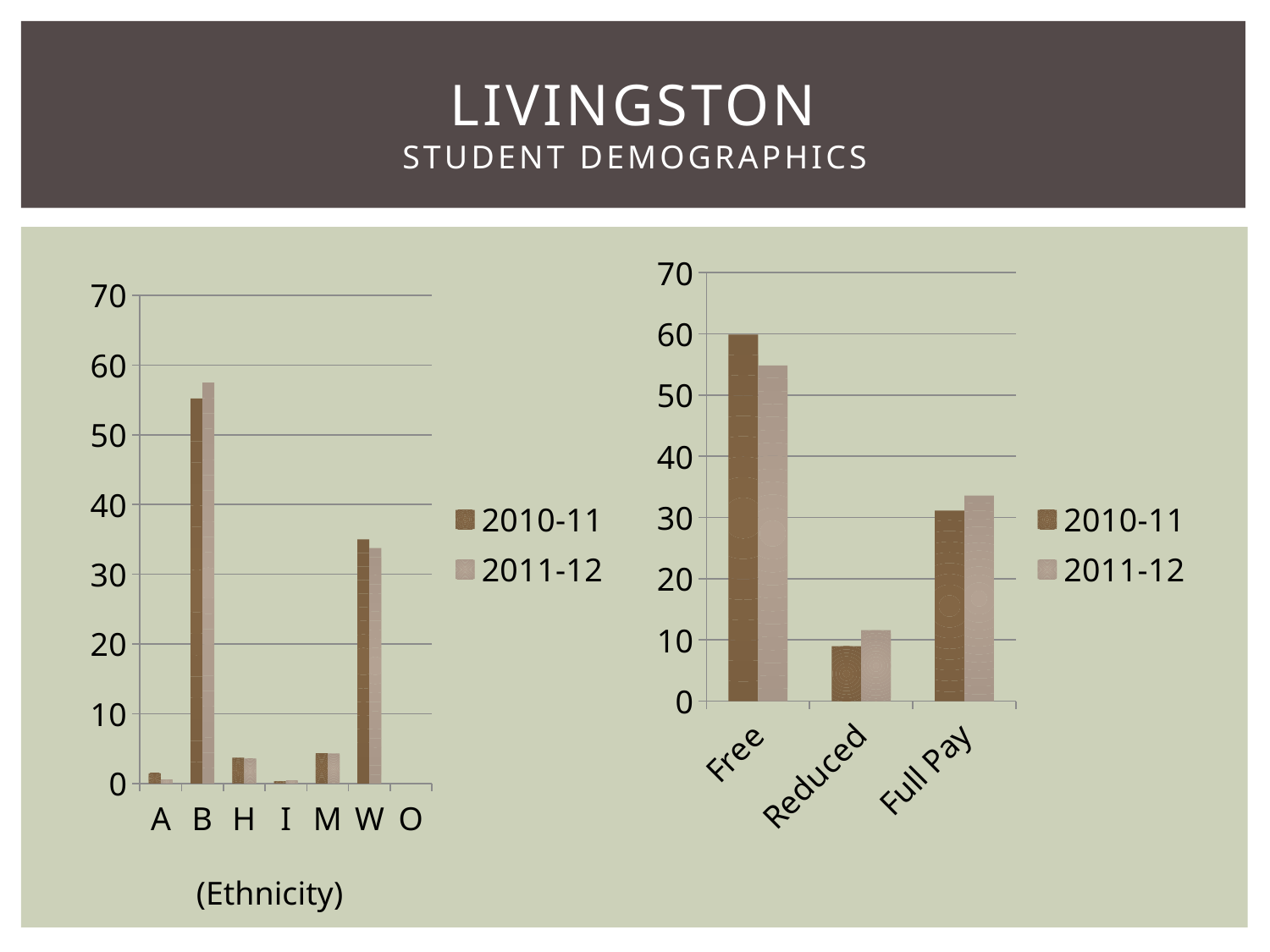
In the right chart (Free/Reduced/Full Pay), which is larger for Full Pay: the 2010-11 value or the 2011-12 value? 2011-12 In the right chart (Free/Reduced/Full Pay), which category has the lowest value for 2011-12? Reduced What are the two series named in the legend of the left chart (Ethnicity)? 2010-11 and 2011-12 In the left chart (Ethnicity), which category has the highest value for 2010-11? B In the right chart (Free/Reduced/Full Pay), which category has the highest value for 2010-11? Free In the left chart (Ethnicity), is the 2011-12 value for B greater or less than 50? greater In the right chart (Free/Reduced/Full Pay), is the 2010-11 value for Reduced greater or less than 10? less In the right chart (Free/Reduced/Full Pay), is the 2011-12 value for Free greater or less than 50? greater In the right chart (Free/Reduced/Full Pay), which is larger for Free: the 2010-11 value or the 2011-12 value? 2010-11 How many categories are shown on the x axis of the left chart (Ethnicity)? 7 What kind of chart is the left chart (Ethnicity)? bar chart How many series does the legend of the right chart (Free/Reduced/Full Pay) list? 2